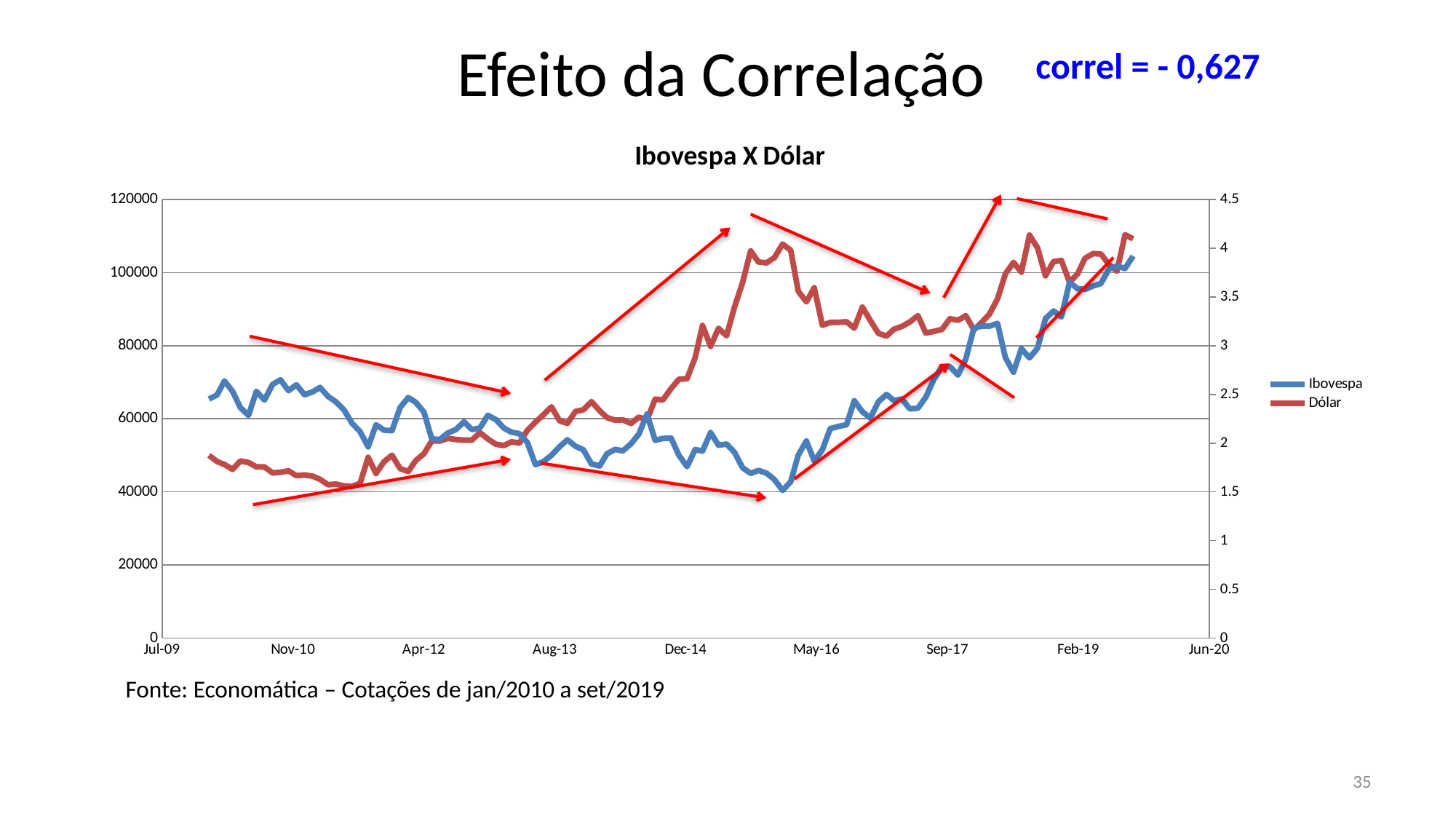
What kind of chart is shown on the slide? line chart What is the title of the chart? Ibovespa X Dólar Which series is drawn in blue? Ibovespa Does the Dólar series overall rise or fall from Jul-09 to the end of the chart? rise What is the maximum value shown on the left vertical axis? 120000 How many series does the legend list? 2 What is the maximum value shown on the right vertical axis? 4.5 Is the Ibovespa value at Nov-10 greater or less than 60000? greater Is the Dólar value at Nov-10 greater or less than 2? less Is the Ibovespa value at Feb-19 greater or less than 80000? greater Around which x-axis label does the Ibovespa series reach its lowest point? May-16